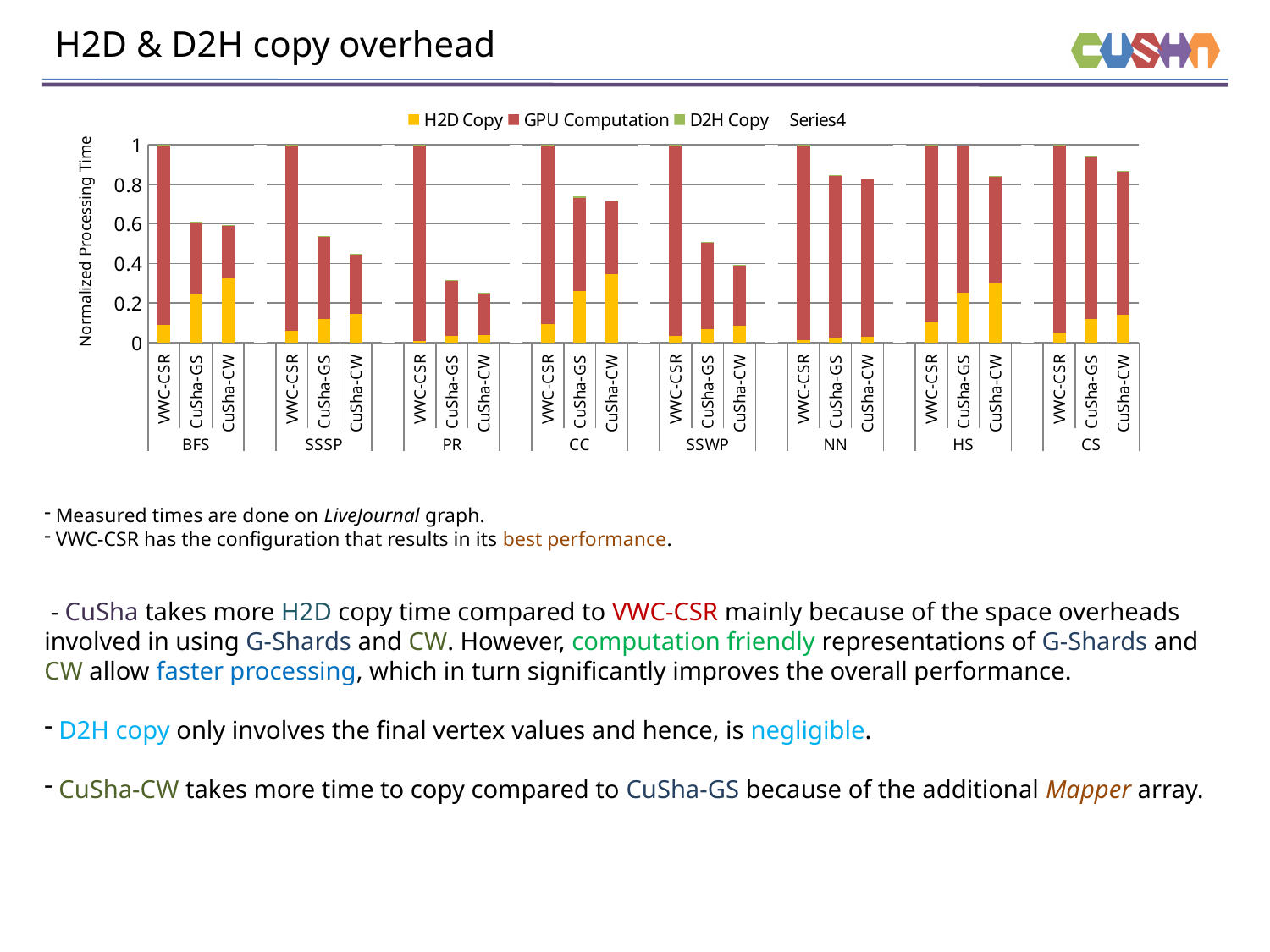
In the HS group, which has the taller total bar, CuSha-GS or CuSha-CW? CuSha-GS What kind of chart is shown on the slide? bar chart In which algorithm group is the CuSha-CW total bar the lowest? PR Is the total bar height for CuSha-CW in the CC group greater or less than 0.6? greater What is the label on the y axis? Normalized Processing Time In the PR group, which has the taller total bar, CuSha-GS or CuSha-CW? CuSha-GS How many algorithm groups (BFS, SSSP, etc.) are shown along the x axis? 8 What is the total normalized processing time for VWC-CSR in the BFS group? 1 How many series does the legend list? 4 Is the total bar height for CuSha-GS in the BFS group greater or less than 0.8? less Is the total bar height for CuSha-GS in the SSSP group greater or less than 0.4? greater